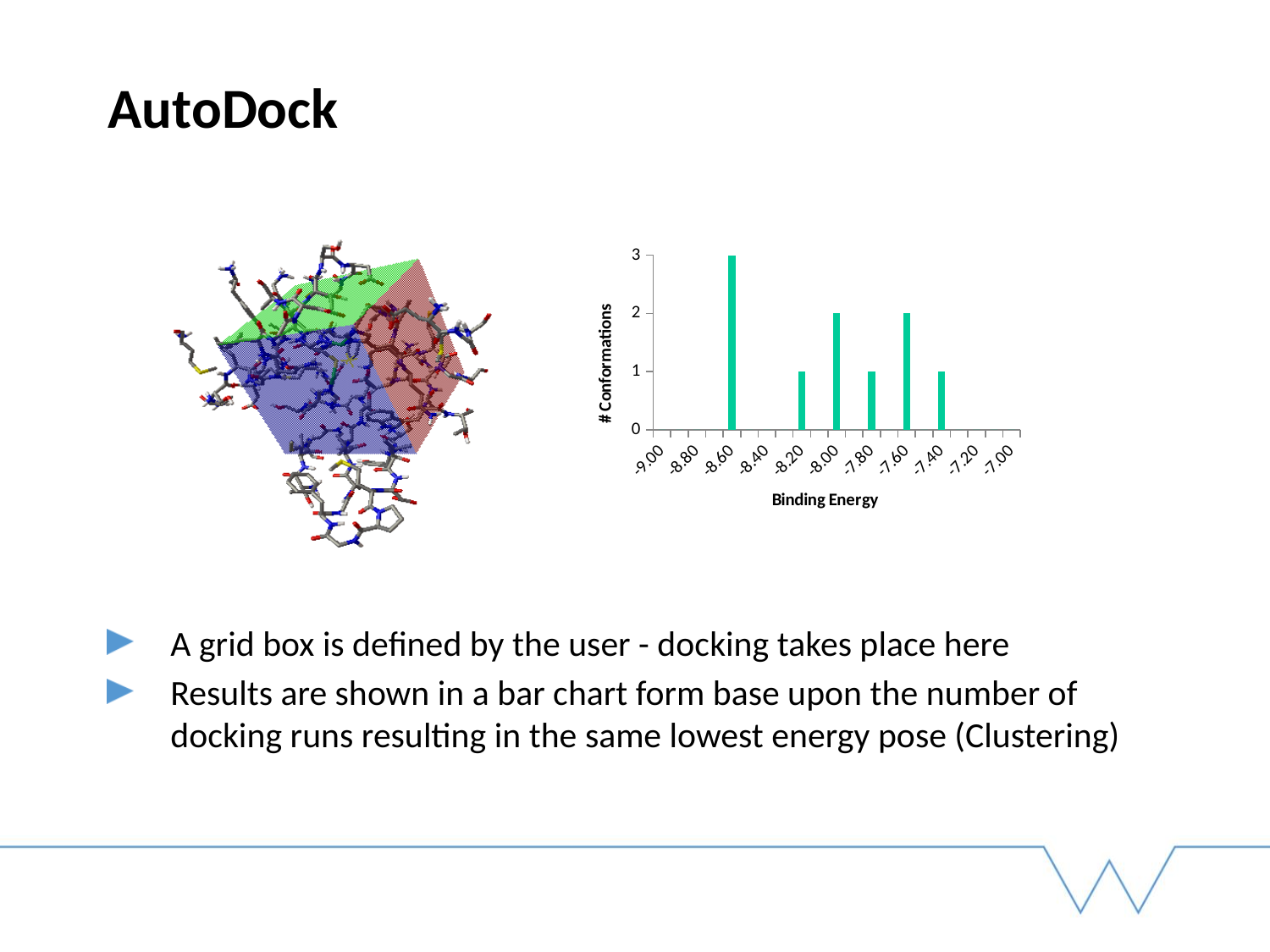
What is the highest number of conformations reached by any bar in the chart? 3 What is the title of the x axis of the chart? Binding Energy What is the difference between the tallest bar and the shortest bar in the chart? 2 Is the value of the tallest bar greater or less than 2? greater How many bars are plotted in the chart? 6 What is the lowest number of conformations shown by any bar in the chart? 1 What is the maximum value shown on the y axis of the chart? 3 What type of chart is shown on the slide? bar chart How many bars in the chart reach 2 conformations? 2 How many bars in the chart show exactly 1 conformation? 3 What is the title of the y axis of the chart? # Conformations What is the total number of conformations across all bars in the chart? 10